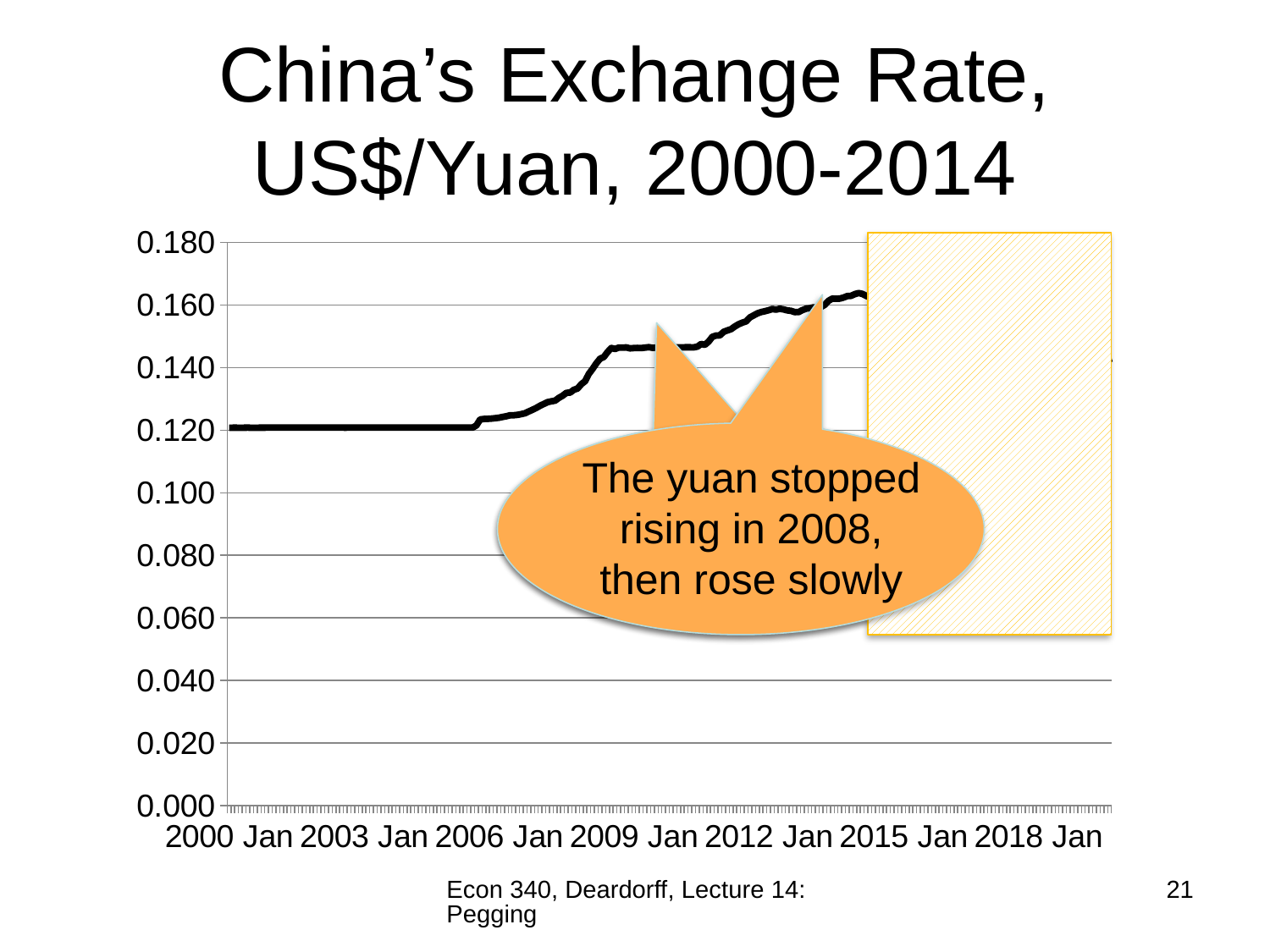
Is the value at the end of the series in 2014 greater or less than 0.180? less Is the value for 2003 Jan greater or less than 0.140? less Is the value for 2009 Jan greater or less than 0.120? greater Overall, does the exchange rate rise or fall from 2000 to 2014? Rise What does the callout on the chart say? The yuan stopped rising in 2008, then rose slowly Which is larger, the exchange rate in 2003 Jan or in 2012 Jan? 2012 Jan Between 2000 and 2005, does the exchange rate rise, fall, or stay flat? Stay flat What is the title of the chart? China's Exchange Rate, US$/Yuan, 2000-2014 What kind of chart is shown on the slide? Line chart